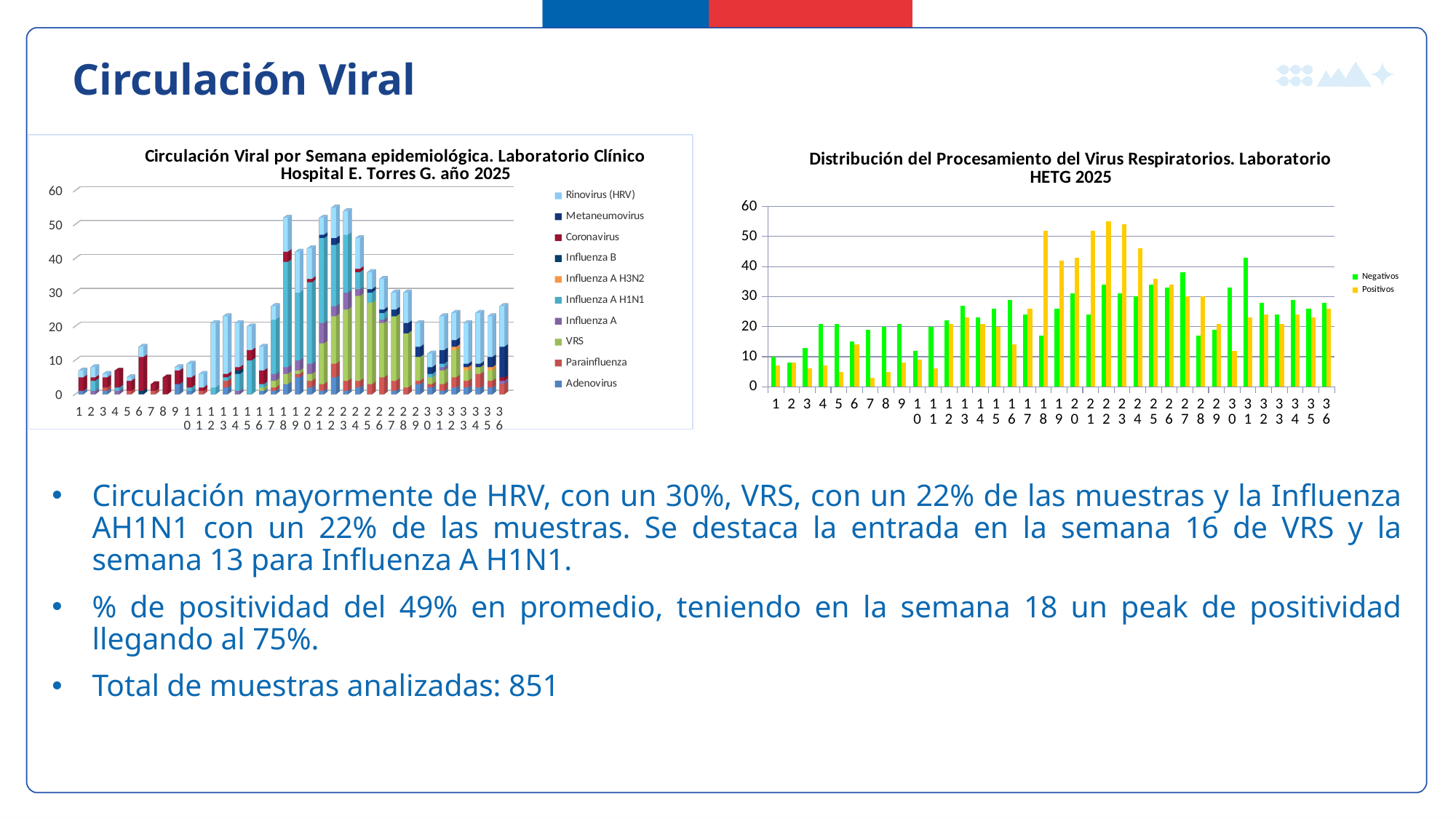
In the right chart, 'Distribución del Procesamiento del Virus Respiratorios', in which week is the Negativos value highest? 31 What kind of chart is the left chart, 'Circulación Viral por Semana epidemiológica'? stacked bar chart In the left chart, 'Circulación Viral por Semana epidemiológica', which series is listed first in the legend? Rinovirus (HRV) How many series does the legend of the right chart, 'Distribución del Procesamiento del Virus Respiratorios', list? 2 In the right chart, 'Distribución del Procesamiento del Virus Respiratorios', which colour represents Positivos? yellow In the right chart, 'Distribución del Procesamiento del Virus Respiratorios', which is larger in week 18: Negativos or Positivos? Positivos In the left chart, 'Circulación Viral por Semana epidemiológica', is the total for week 1 greater or less than 10? less What kind of chart is the right chart, 'Distribución del Procesamiento del Virus Respiratorios'? bar chart In the right chart, 'Distribución del Procesamiento del Virus Respiratorios', is the Positivos value for week 22 greater or less than 50? greater In the left chart, 'Circulación Viral por Semana epidemiológica', is the total for week 22 greater or less than 50? greater How many series does the legend of the left chart, 'Circulación Viral por Semana epidemiológica', list? 10 How many epidemiological weeks are plotted on the x axis of the left chart, 'Circulación Viral por Semana epidemiológica'? 36